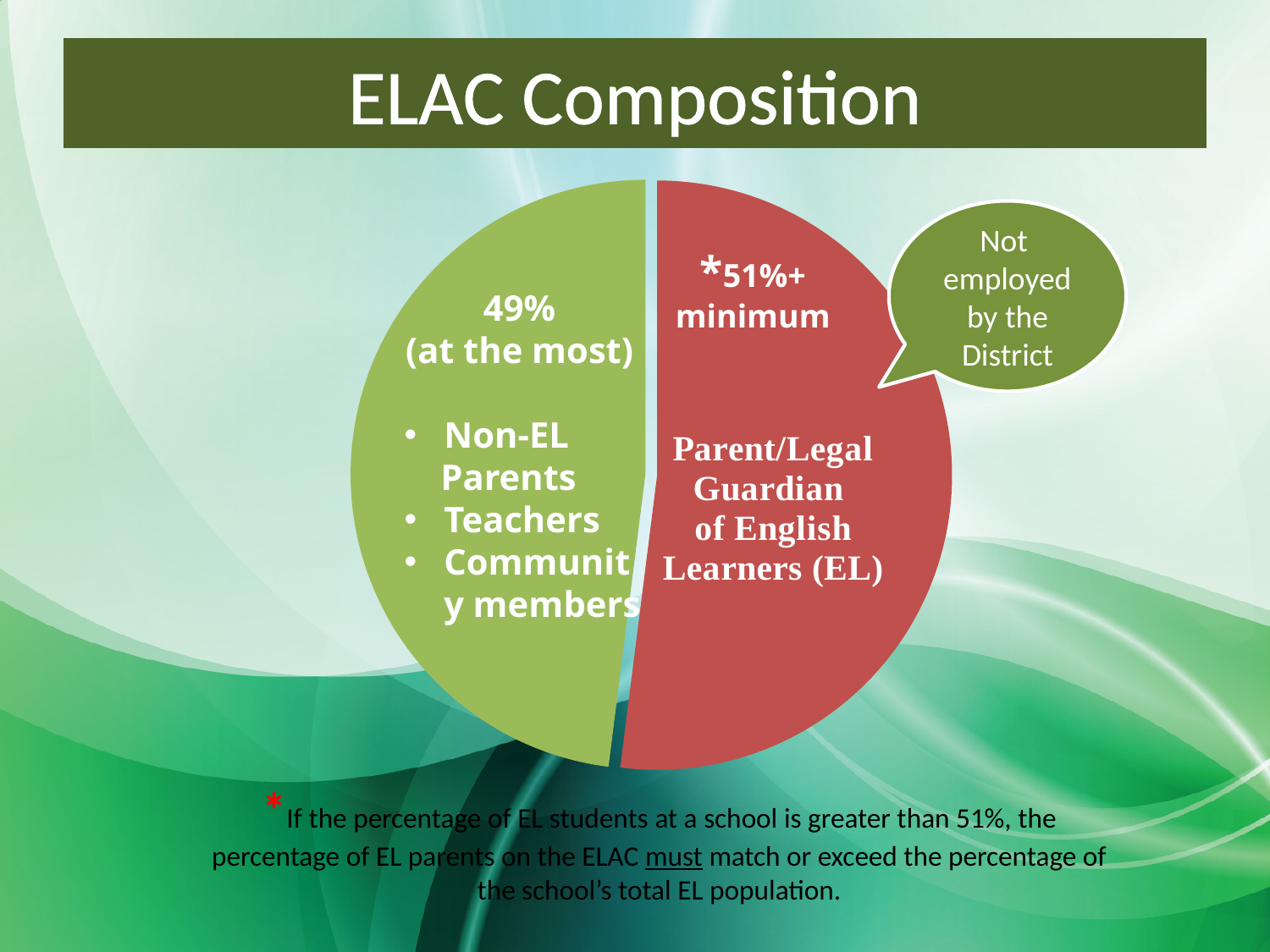
Which slice of the pie chart is larger, the green slice or the red slice? The red slice What is the title of the chart? ELAC Composition What percentage is shown for the red slice of the pie chart? 51%+ minimum Is the share of the green slice greater or less than 50%? less What kind of chart is shown on the slide? Pie chart Which group does the red slice of the pie chart represent? Parent/Legal Guardian of English Learners (EL) Which slice of the pie chart is the smallest? 49% (at the most) Which slice of the pie chart is the largest? 51%+ minimum Is the share of the red slice greater or less than 50%? greater What percentage is shown for the green slice of the pie chart? 49% (at the most) How many slices does the pie chart have? 2